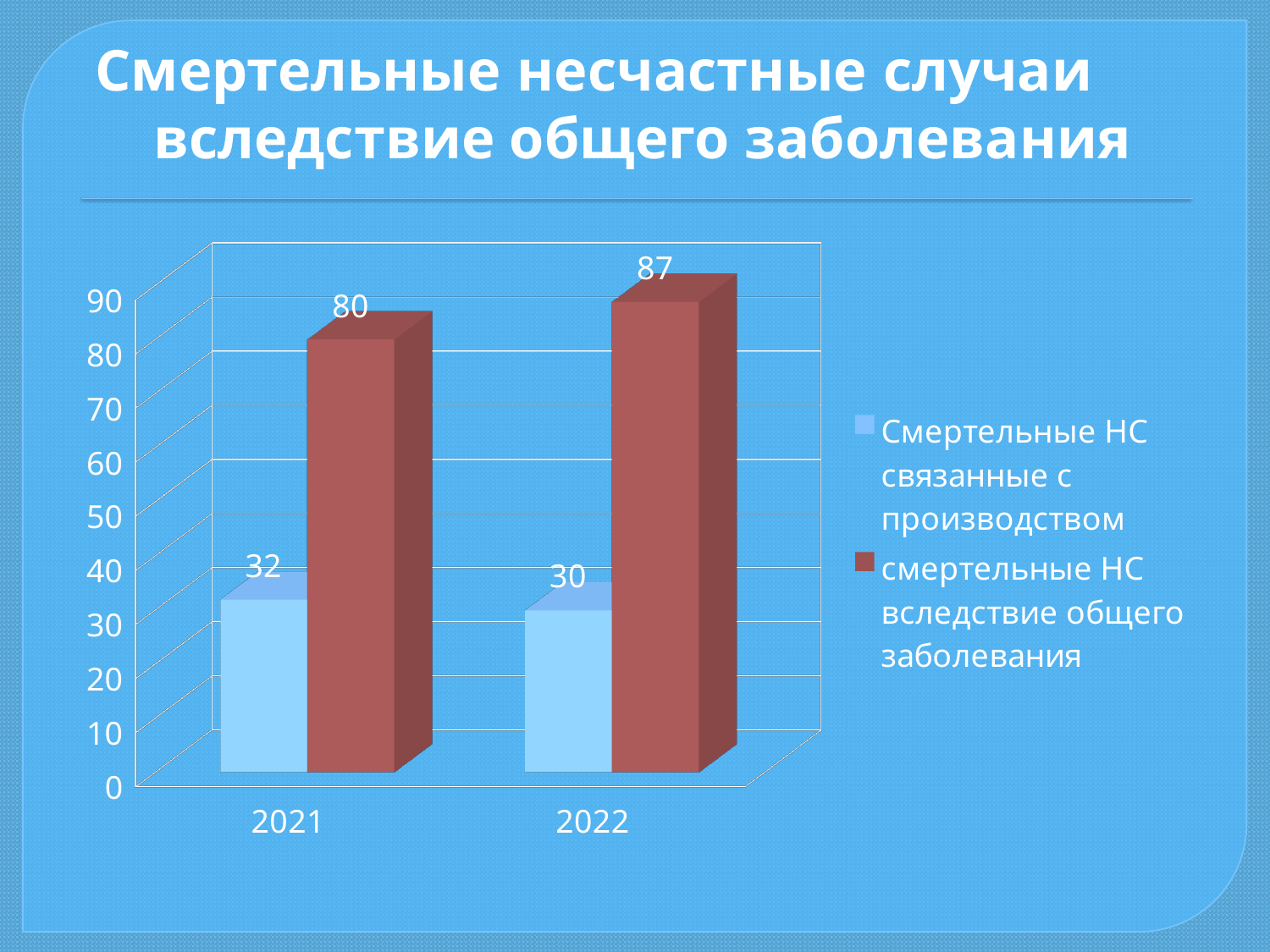
What is the value for 'Смертельные НС связанные с производством' in 2022? 30 How many years are shown on the x axis? 2 What is the value for 'смертельные НС вследствие общего заболевания' in 2022? 87 What is the difference between the two series in 2022? 57 What is the value for 'смертельные НС вследствие общего заболевания' in 2021? 80 How many series does the legend list? 2 What kind of chart is shown on the slide? Bar chart What is the value for 'Смертельные НС связанные с производством' in 2021? 32 In which year is 'смертельные НС вследствие общего заболевания' highest? 2022 Which series has the larger value in 2021? смертельные НС вследствие общего заболевания By how much did 'смертельные НС вследствие общего заболевания' change from 2021 to 2022? 7 In which year is 'Смертельные НС связанные с производством' lowest? 2022